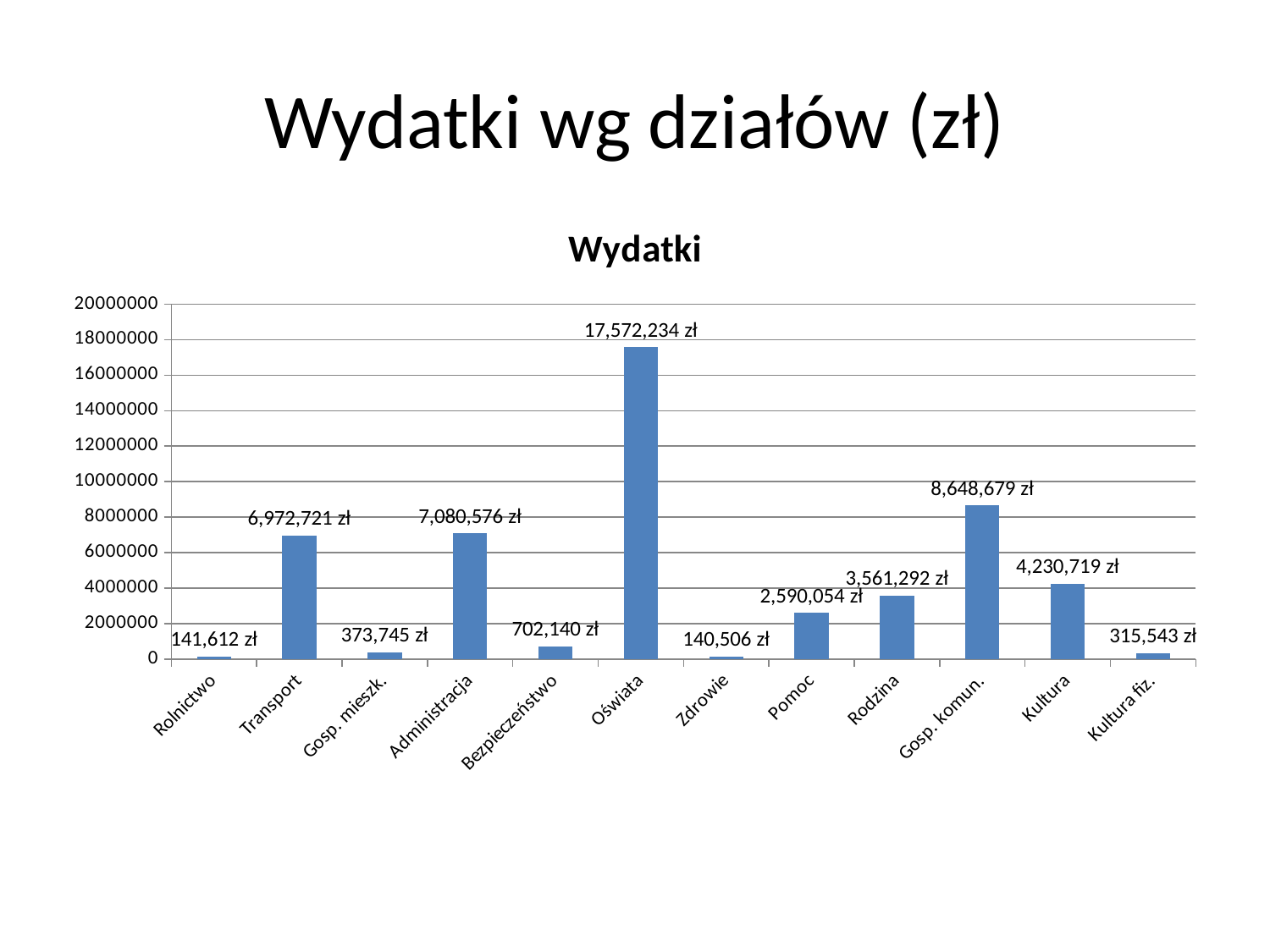
Which category has the highest value? Oświata Which category has the lowest value? Zdrowie What is the difference between the values for Gosp. komun. and Kultura? 4,417,960 zł What kind of chart is shown? Bar chart Is the value for Kultura greater or less than 4000000? greater What is the value for Gosp. komun.? 8,648,679 zł What is the difference between the values for Rodzina and Pomoc? 971,238 zł Which is larger, the value for Administracja or the value for Transport? Administracja What is the value for Bezpieczeństwo? 702,140 zł How many categories are shown on the x axis? 12 What is the value for Oświata? 17,572,234 zł What is the value for Kultura fiz.? 315,543 zł